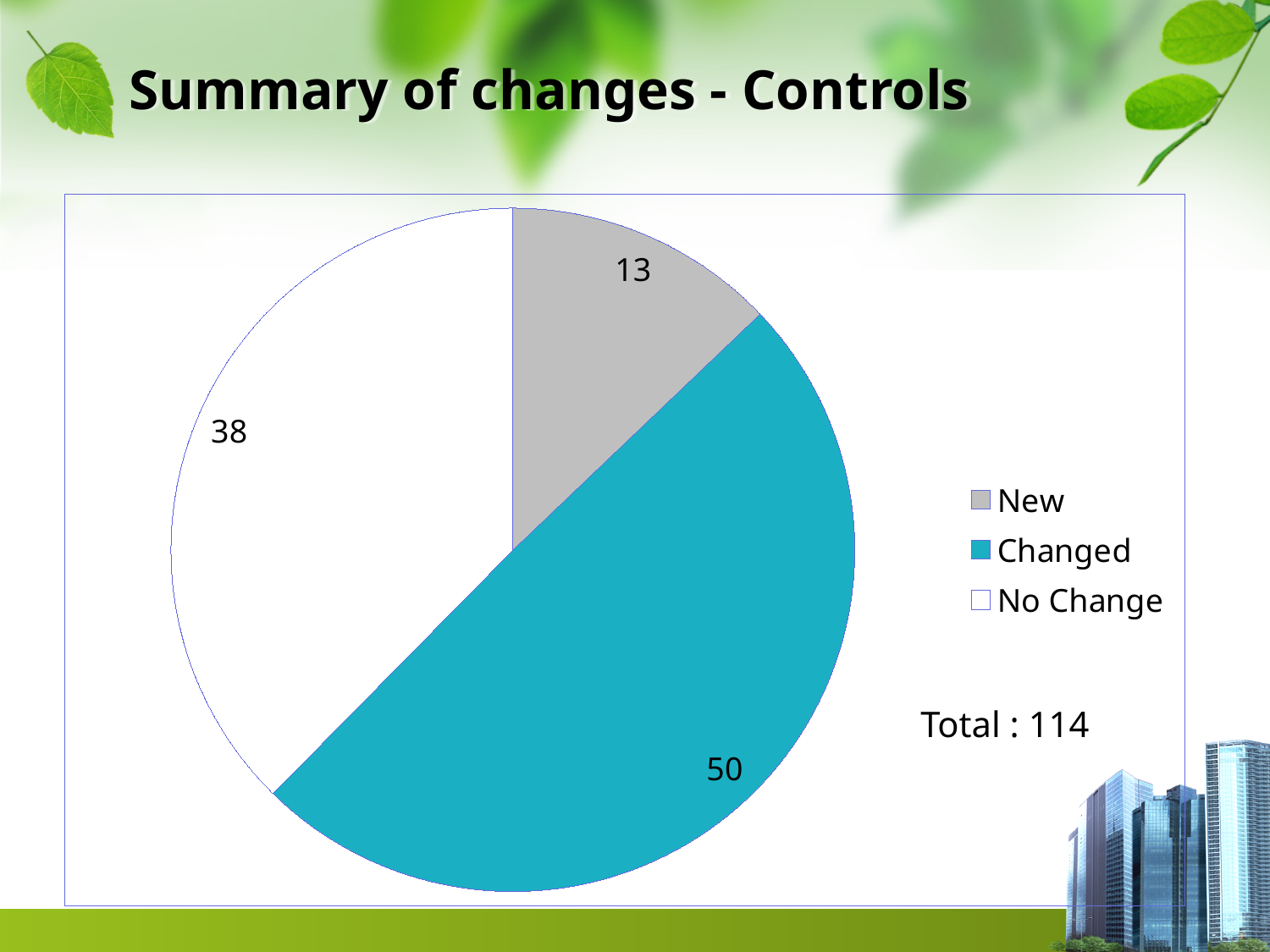
What is the difference between the No Change value and the New value? 25 Which category has the smallest slice of the pie? New What is the title of the slide containing the chart? Summary of changes - Controls What kind of chart is shown on the slide? pie chart What is the value for the New slice? 13 What is the difference between the Changed value and the No Change value? 12 What is the value for the No Change slice? 38 Which is larger, the value for Changed or the value for No Change? Changed What total is printed next to the chart? Total : 114 What is the value for the Changed slice? 50 Which category has the largest slice of the pie? Changed How many categories does the pie chart have? 3